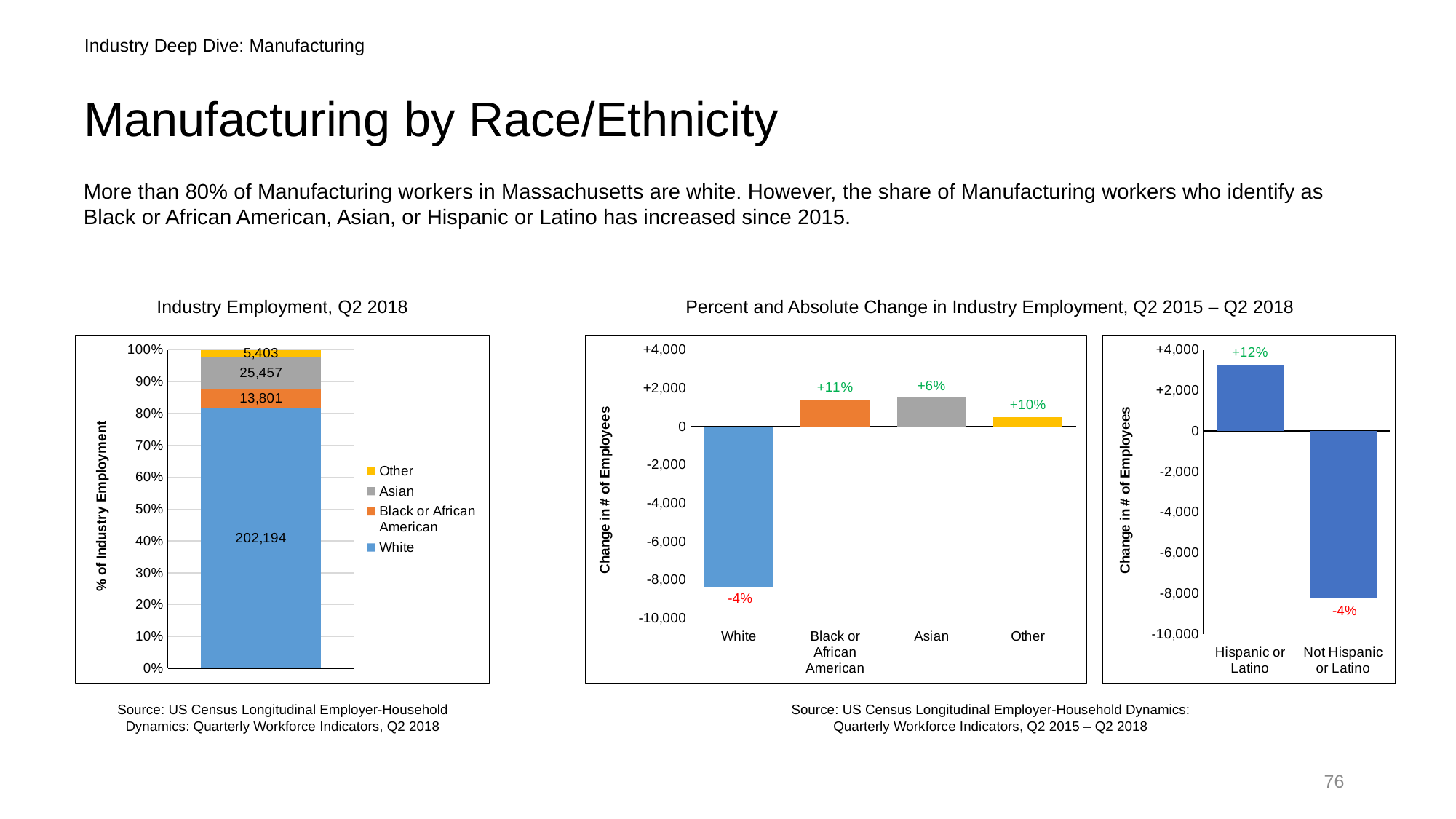
In the middle chart (Percent and Absolute Change in Industry Employment by race), what percent change is shown for White? -4% In the Industry Employment, Q2 2018 chart, which segment has the smallest value? Other In the Industry Employment, Q2 2018 chart, what is the value shown for Asian? 25,457 In the Industry Employment, Q2 2018 chart, what is the value shown for White? 202,194 In the Industry Employment, Q2 2018 chart, how many series does the legend list? 4 In the right-hand chart (change in employment for Hispanic or Latino vs Not Hispanic or Latino), what percent change is shown for Hispanic or Latino? +12% In the middle chart (Percent and Absolute Change in Industry Employment by race), how many categories are shown on the x axis? 4 In the Industry Employment, Q2 2018 chart, what is the total of the four labelled segments in the stacked bar? 246,855 In the right-hand chart (change in employment for Hispanic or Latino vs Not Hispanic or Latino), is the change in number of employees for Hispanic or Latino greater or less than 2,000? greater What kind of chart is the right-hand chart showing change in employment for Hispanic or Latino and Not Hispanic or Latino? bar chart In the middle chart (Percent and Absolute Change in Industry Employment by race), what percent change is shown for Black or African American? +11% In the middle chart (Percent and Absolute Change in Industry Employment by race), is the change in number of employees for White greater or less than -6,000? less